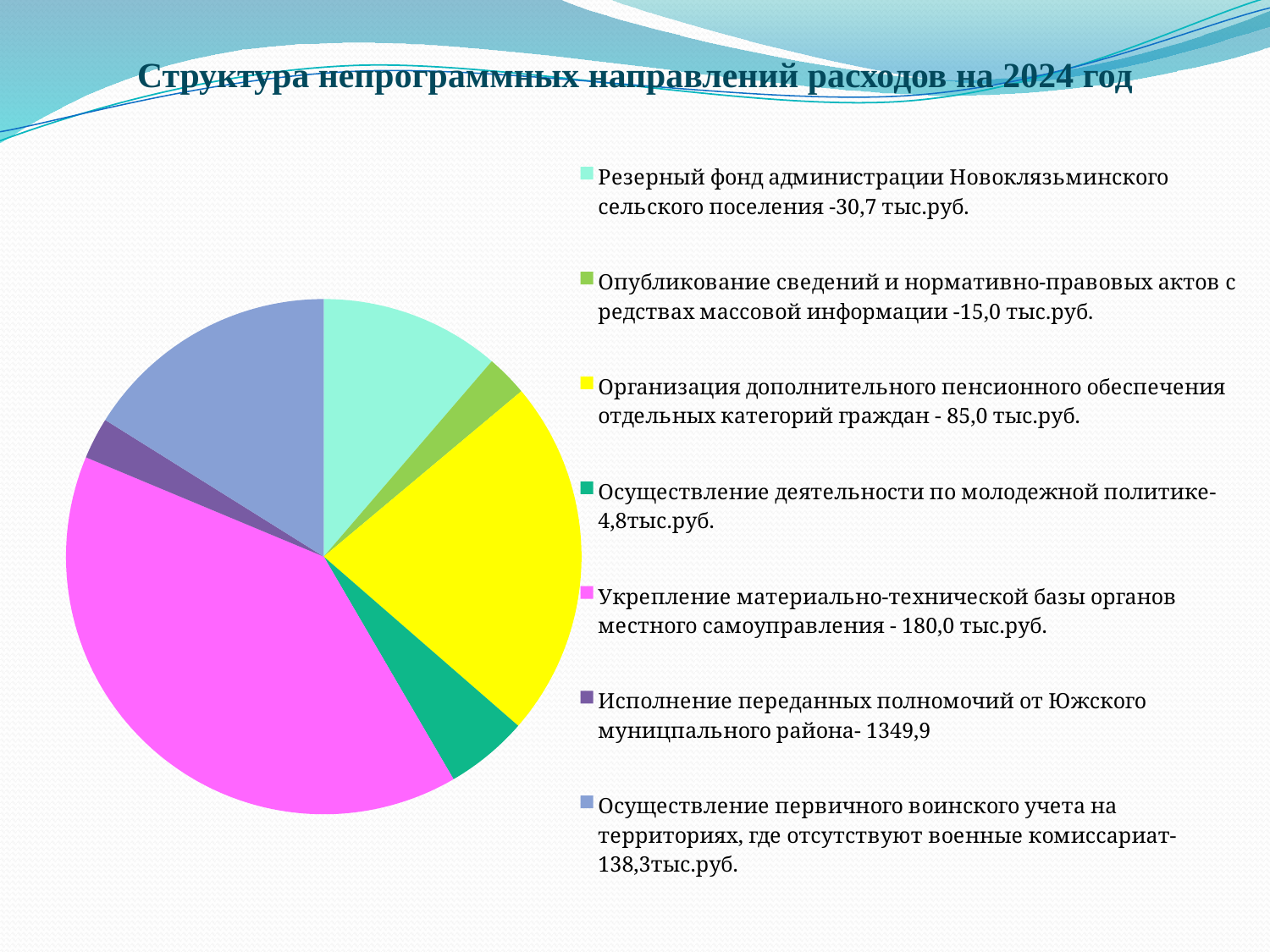
What value is given for «Осуществление первичного воинского учета на территориях, где отсутствуют военные комиссариат»? 138,3 тыс.руб. What value is given for «Опубликование сведений и нормативно-правовых актов с редствах массовой информации»? 15,0 тыс.руб. What is the difference between «Укрепление материально-технической базы органов местного самоуправления» (180,0) and «Организация дополнительного пенсионного обеспечения отдельных категорий граждан» (85,0)? 95,0 тыс.руб. What value is given for «Организация дополнительного пенсионного обеспечения отдельных категорий граждан»? 85,0 тыс.руб. What colour is the slice for «Организация дополнительного пенсионного обеспечения отдельных категорий граждан»? yellow Which is larger: «Укрепление материально-технической базы органов местного самоуправления» or «Организация дополнительного пенсионного обеспечения отдельных категорий граждан»? Укрепление материально-технической базы органов местного самоуправления What value is given for «Резерный фонд администрации Новоклязьминского сельского поселения»? 30,7 тыс.руб. What is the title of the chart on the slide? Структура непрограммных направлений расходов на 2024 год What value is given for «Осуществление деятельности по молодежной политике»? 4,8 тыс.руб. What kind of chart is shown on the slide? pie chart What value is given for «Укрепление материально-технической базы органов местного самоуправления»? 180,0 тыс.руб. How many categories (slices) does the pie chart have? 7